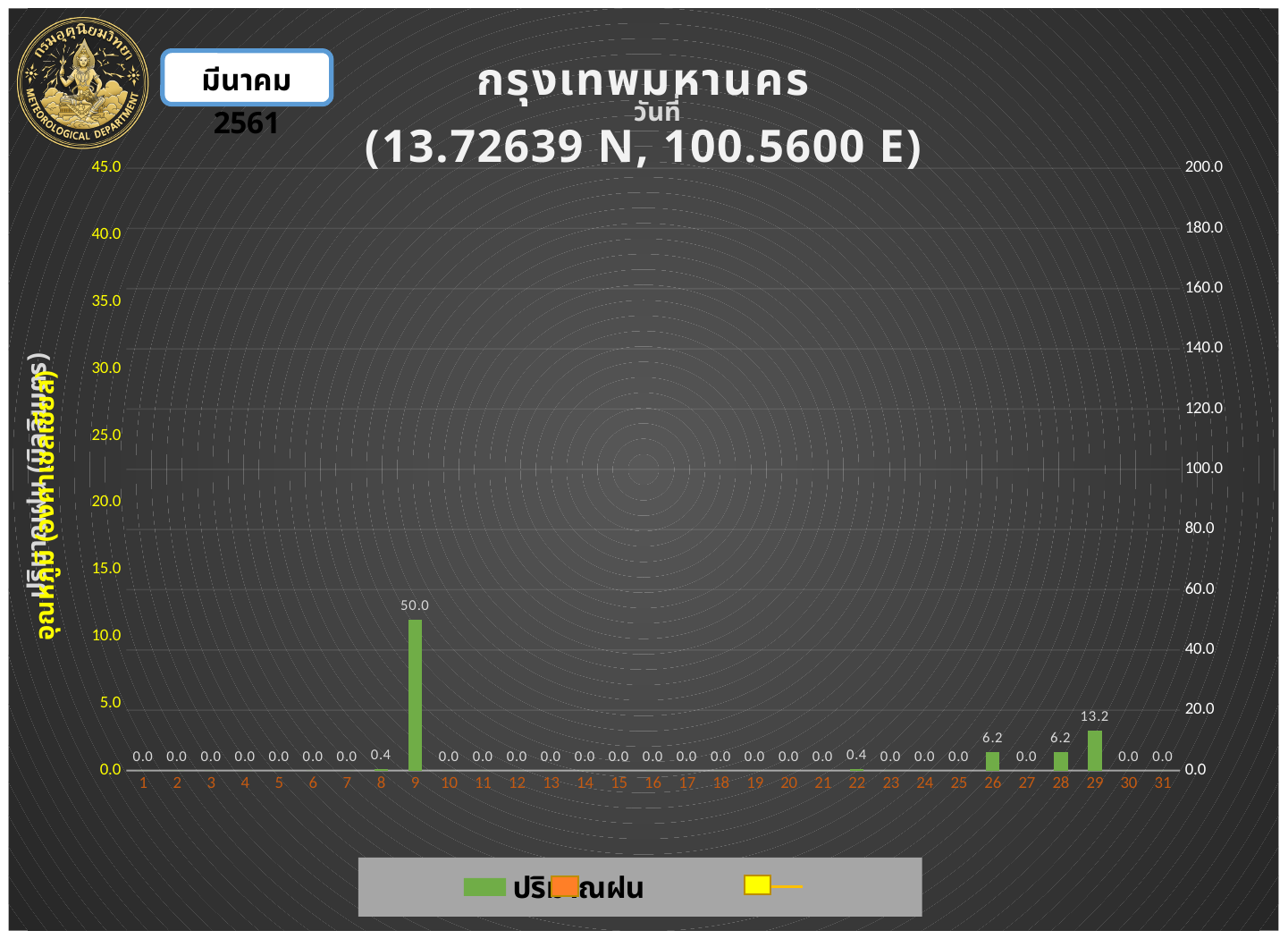
What is the difference between the rainfall values for day 9 and day 29? 36.8 What coordinates are given in the chart title? 13.72639 N, 100.5600 E Is the rainfall value for day 9 greater or less than 40.0 on the right axis? greater Which day has the highest rainfall value? 9 What is the rainfall value shown for day 8? 0.4 How many days are shown on the x axis? 31 What is the rainfall value shown for day 29? 13.2 What is the difference between the rainfall values for day 29 and day 28? 7.0 What is the rainfall value shown for day 9? 50.0 What is the rainfall value shown for day 26? 6.2 What kind of chart is shown on the slide? bar chart Which day has the larger rainfall value, day 26 or day 29? 29